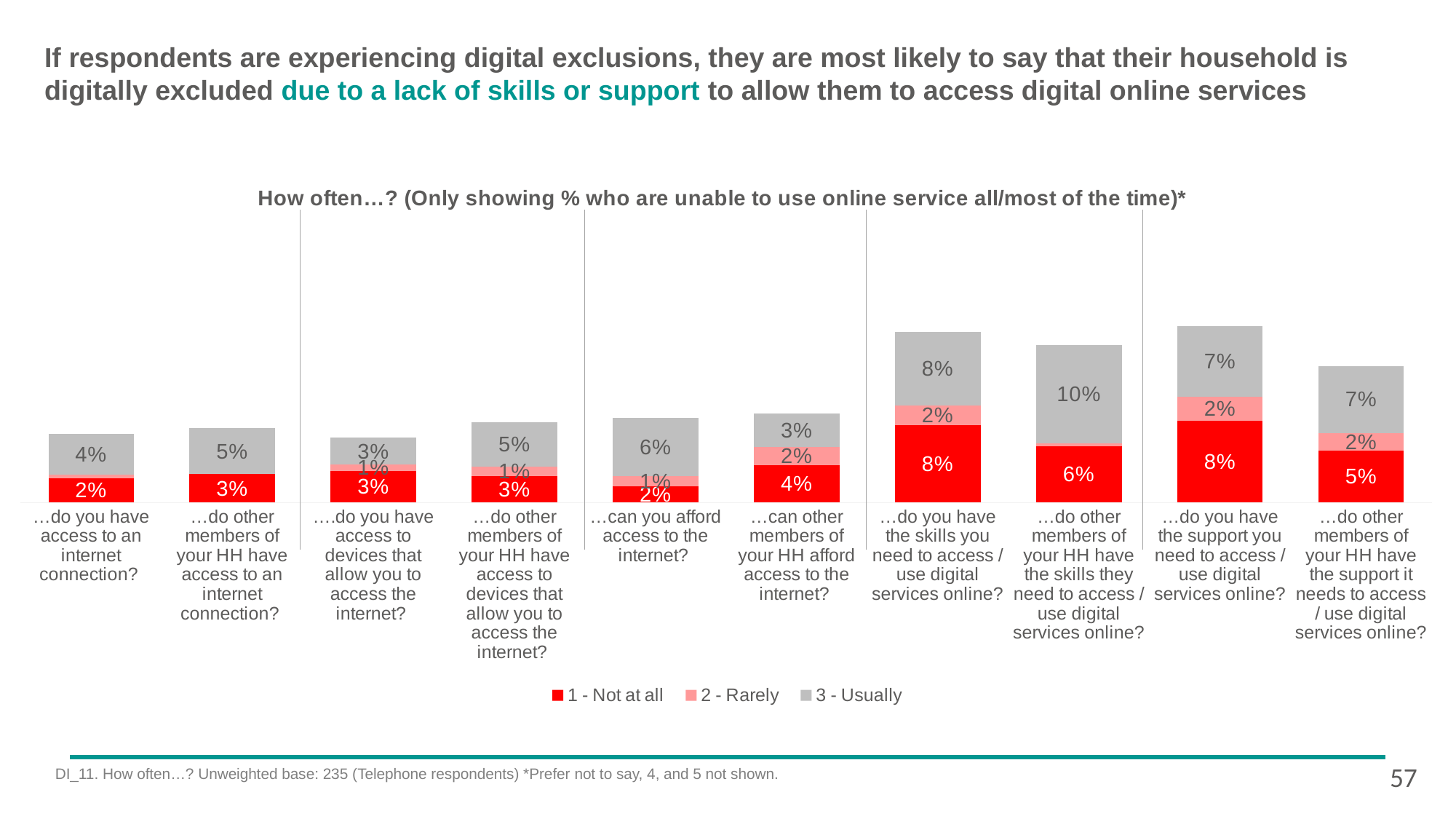
Which series in the legend is shown in red? 1 - Not at all What is the '2 - Rarely' value for '…can other members of your HH afford access to the internet?'? 2% What kind of chart is shown on the slide? Stacked bar chart How many series does the legend list? 3 What is the total of the stacked bar for '…do other members of your HH have the support it needs to access / use digital services online?'? 14% Which has the larger '1 - Not at all' value: '…can you afford access to the internet?' or '…can other members of your HH afford access to the internet?'? …can other members of your HH afford access to the internet? What is the total of the stacked bar for '…do you have the skills you need to access / use digital services online?'? 18% What is the difference between the '3 - Usually' values for '…do other members of your HH have the skills they need…' (10%) and '…do you have the skills you need…' (8%)? 2 percentage points How many question categories are plotted along the x axis? 10 What is the '1 - Not at all' value for '…do you have the skills you need to access / use digital services online?'? 8% Which category has the highest '3 - Usually' value? …do other members of your HH have the skills they need to access / use digital services online? What is the '3 - Usually' value for '…do other members of your HH have the skills they need to access / use digital services online?'? 10%